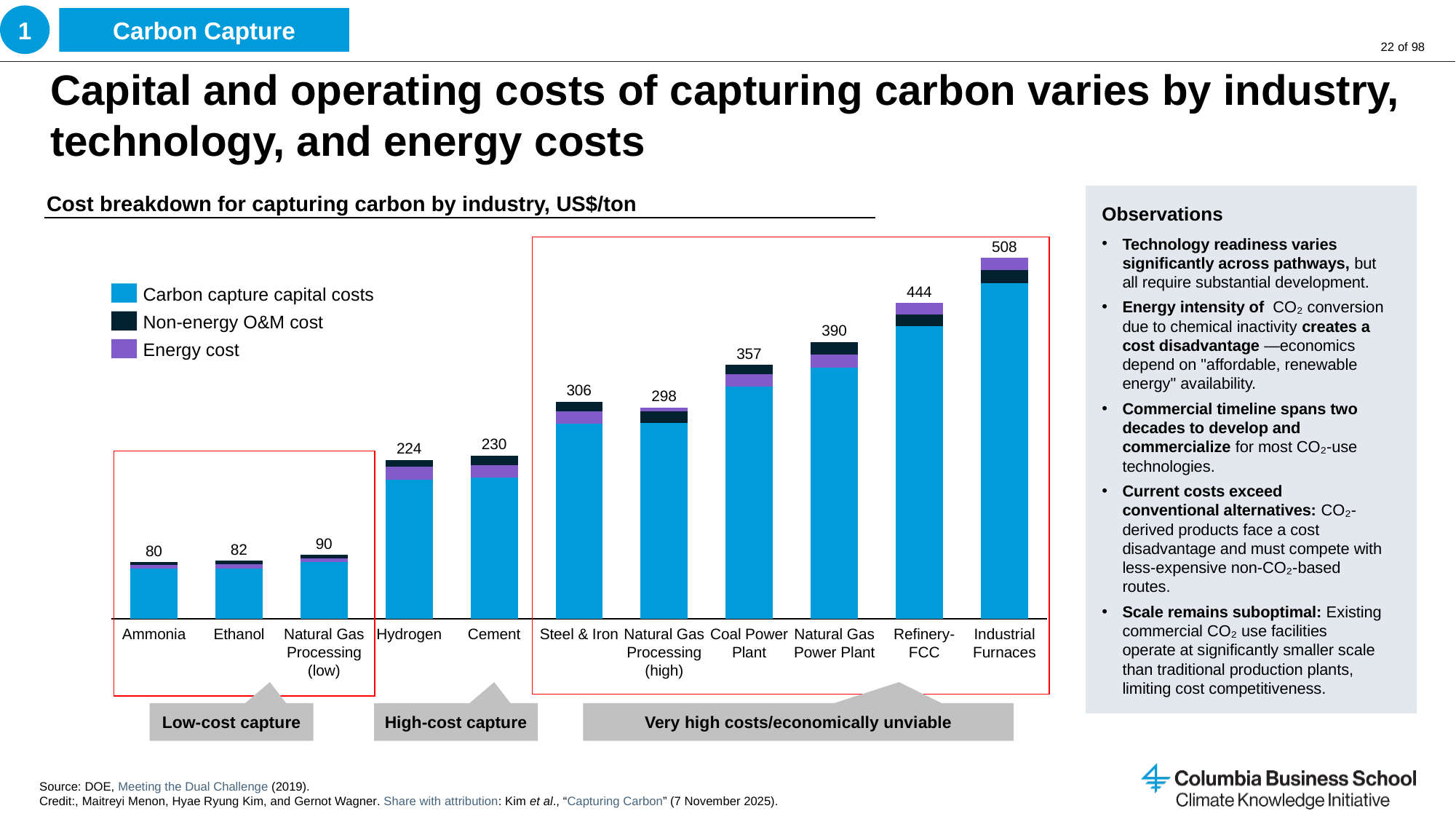
Which industries are grouped under the 'Low-cost capture' label? Ammonia, Ethanol, Natural Gas Processing (low) What is the total cost of capturing carbon for Coal Power Plant, in US$/ton? 357 Which industry has the lowest total cost of capturing carbon? Ammonia What kind of chart is used to show the cost breakdown for capturing carbon by industry? Stacked bar chart How many industries are shown on the x axis of the chart? 11 Which has a higher total cost of capturing carbon, Steel & Iron or Natural Gas Processing (high)? Steel & Iron What is the total cost of capturing carbon for Hydrogen, in US$/ton? 224 Which industry has the highest total cost of capturing carbon? Industrial Furnaces What is the total cost of capturing carbon for Industrial Furnaces, in US$/ton? 508 What is the difference between the total cost for Refinery-FCC and the total cost for Natural Gas Power Plant, in US$/ton? 54 Which cost component is shown in purple in the chart legend? Energy cost How many series does the chart legend list? 3